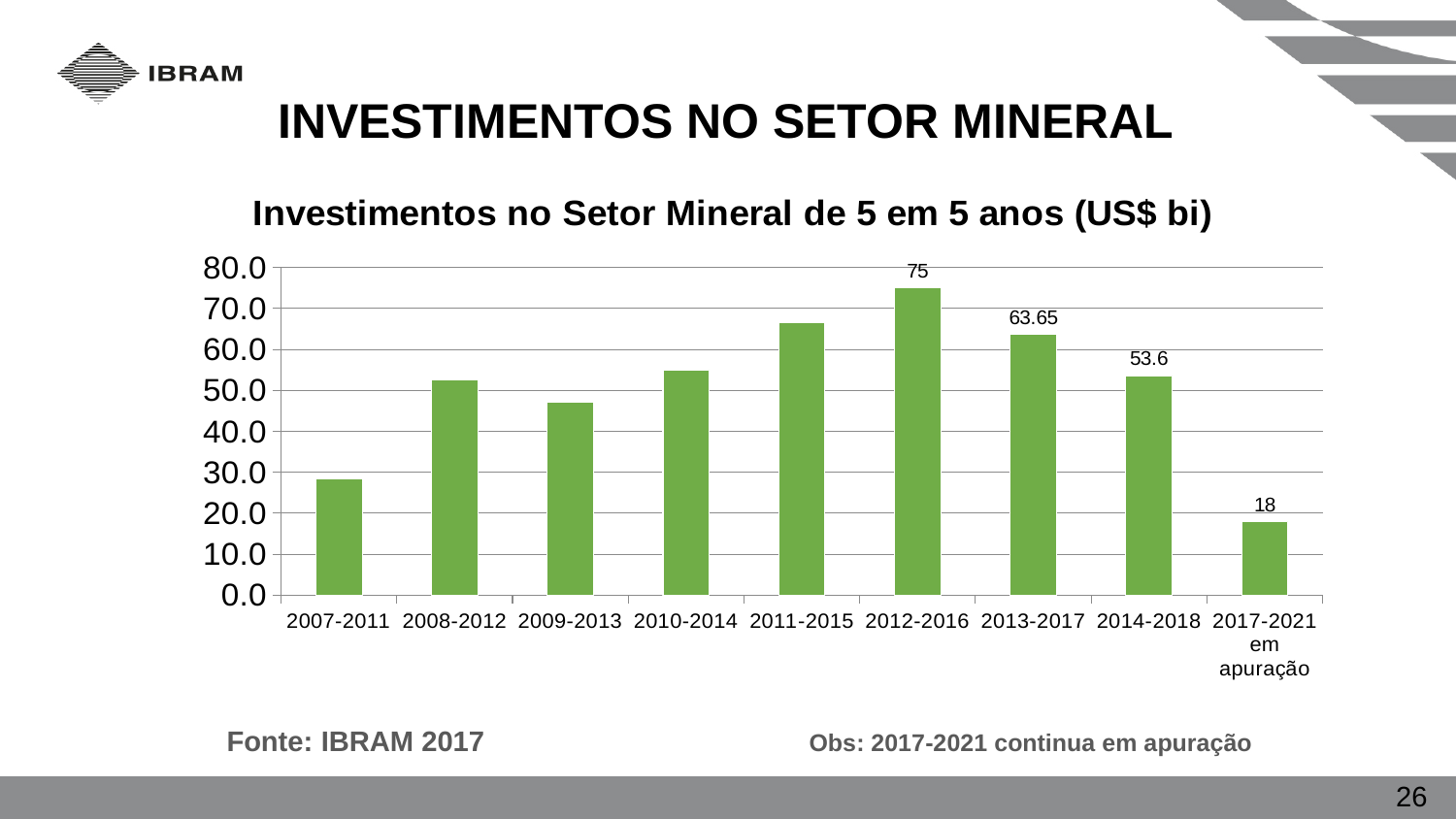
Is the value for 2011-2015 greater or less than 60.0? greater How many periods are shown on the x axis? 9 What is the value for 2014-2018? 53.6 What kind of chart is shown? bar chart What is the difference between the values for 2012-2016 and 2013-2017? 11.35 What is the value for 2012-2016? 75 Which is larger, the value for 2013-2017 or the value for 2014-2018? 2013-2017 Is the value for 2007-2011 greater or less than 30.0? less Which period has the lowest value? 2017-2021 em apuração What is the value for 2013-2017? 63.65 Which period has the highest value? 2012-2016 What is the value for 2017-2021 em apuração? 18